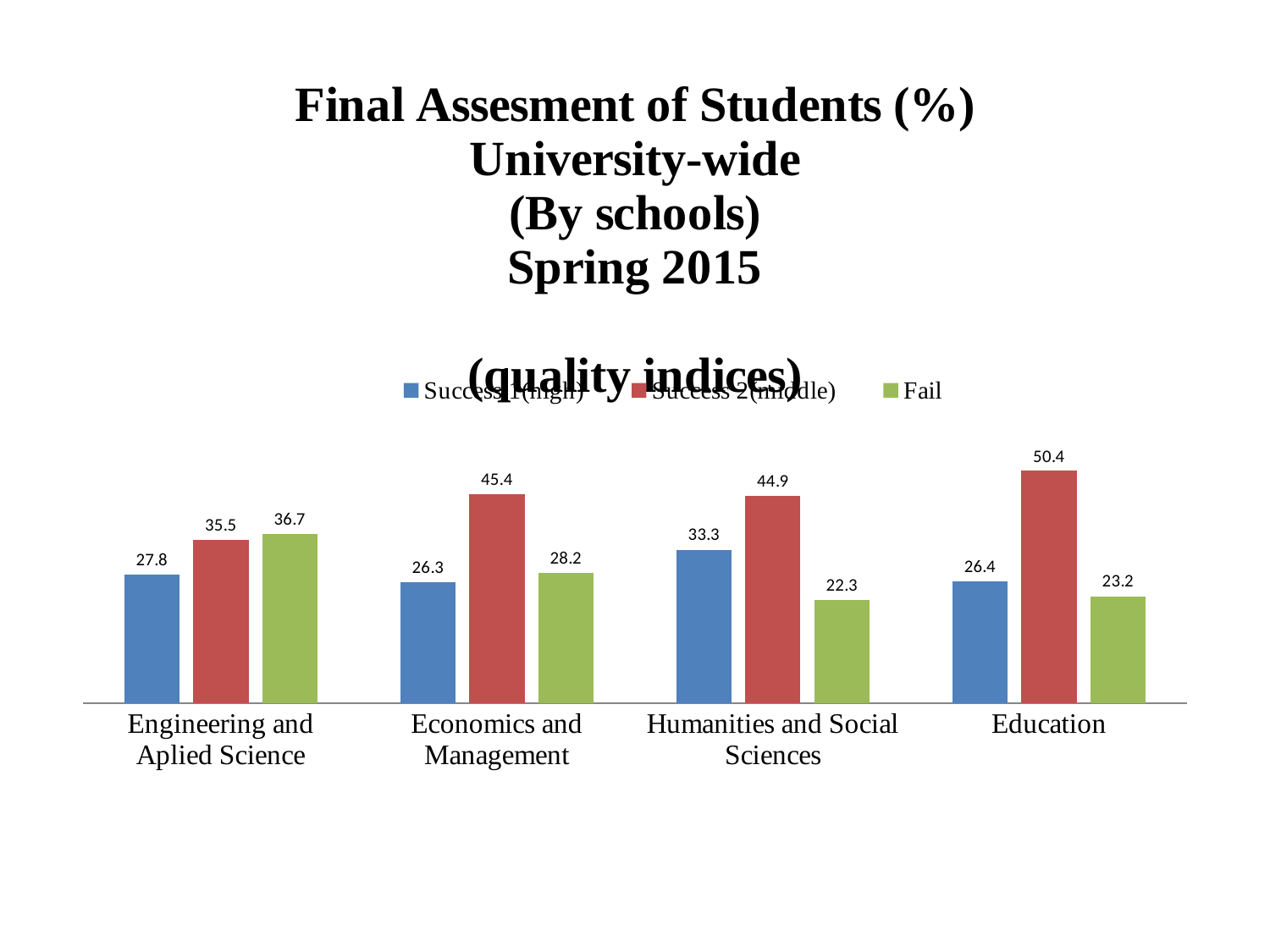
What is the difference between the red (middle) bar and the Fail bar for Education? 27.2 How many series does the legend list? 3 What colour are the Fail bars? Green What is the Fail value for Economics and Management? 28.2 What is the value of the blue (first) bar for Humanities and Social Sciences? 33.3 Which is larger for Engineering and Aplied Science: the red (middle) bar or the Fail bar? Fail bar Which school has the highest Fail value? Engineering and Aplied Science What is the value of the red (middle) bar for Education? 50.4 What kind of chart is shown on the slide? Bar chart Which school has the lowest Fail value? Humanities and Social Sciences Which school has the highest value for the red (middle) series? Education How many schools are shown on the x axis? 4